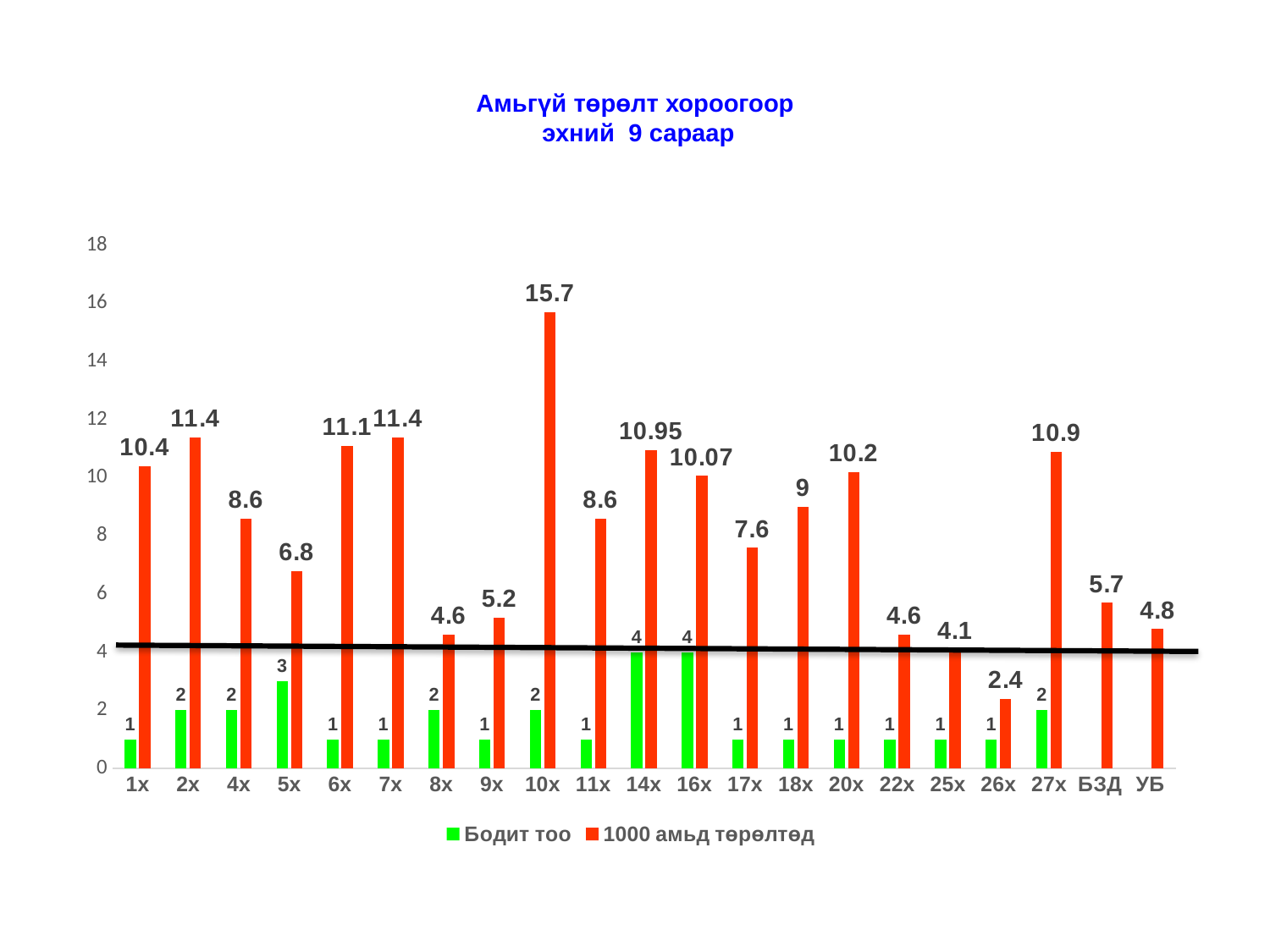
How many series does the legend list? 2 What is the title of the chart? Амьгүй төрөлт хороогоор эхний 9 сараар What is the value of the 1000 амьд төрөлтөд series for 10х? 15.7 What is the value of the Бодит тоо series for 5х? 3 What is the value of the 1000 амьд төрөлтөд series for УБ? 4.8 Which has a larger 1000 амьд төрөлтөд value, 17х or 18х? 18х What is the difference between the 1000 амьд төрөлтөд values for 10х and 26х? 13.3 What kind of chart is shown on the slide? bar chart How many categories are shown on the x axis? 21 Which category has the highest value in the 1000 амьд төрөлтөд series? 10х Is the 1000 амьд төрөлтөд value for 5х greater or less than 6? greater Which category has the lowest value in the 1000 амьд төрөлтөд series? 26х